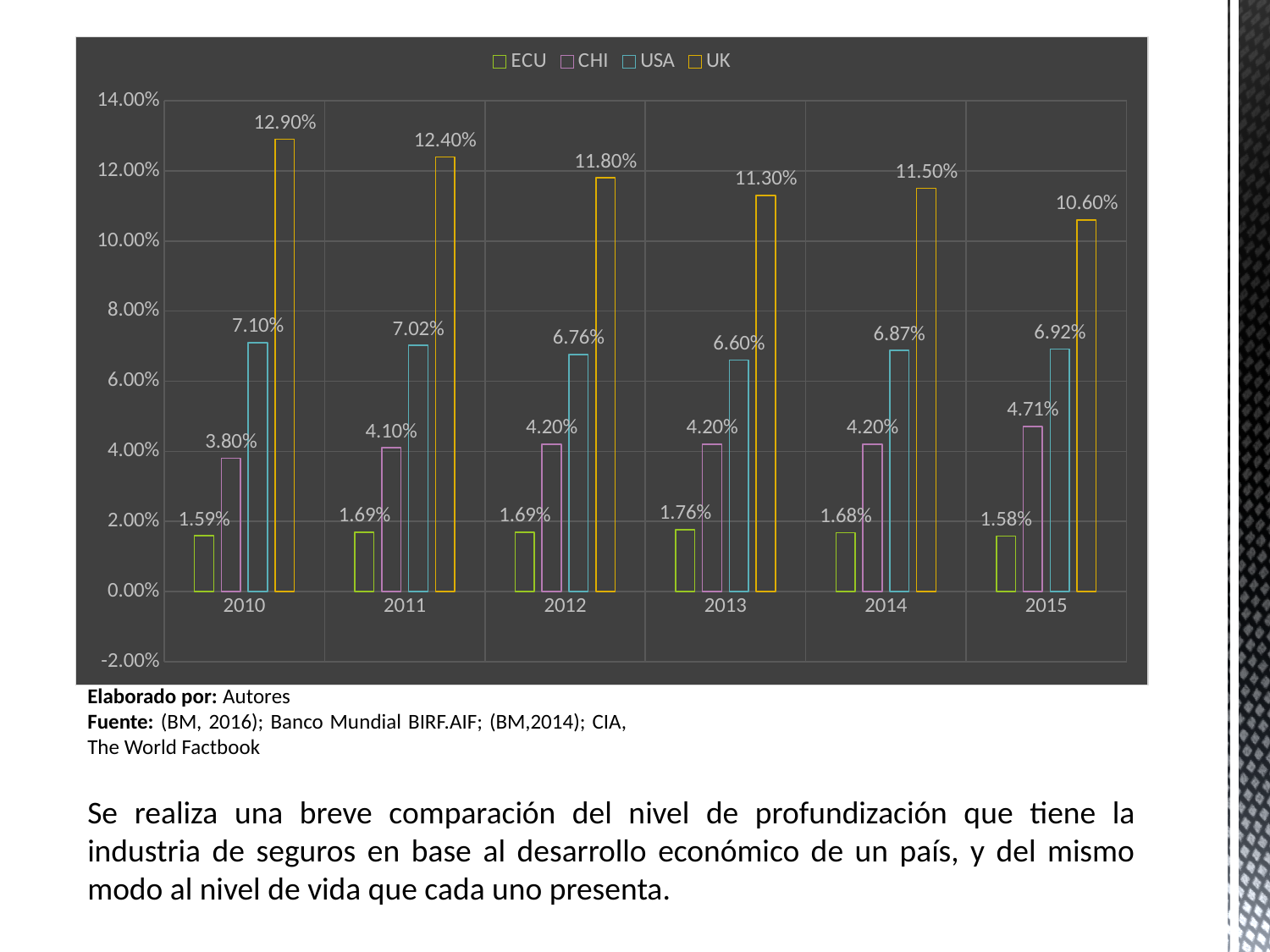
What is the value for USA in 2013? 6.60% How many series does the legend list? 4 Does the UK value rise or fall from 2010 to 2015? Fall In which year is the UK value highest? 2010 What kind of chart is shown on the slide? Bar chart What is the difference between the UK value and the USA value in 2015? 3.68% In which year is the ECU value lowest? 2015 What is the value for CHI in 2015? 4.71% What is the value for ECU in 2013? 1.76% How many years are shown on the x axis? 6 What is the value for UK in 2010? 12.90% Which is larger, the CHI value in 2011 or the CHI value in 2015? CHI in 2015